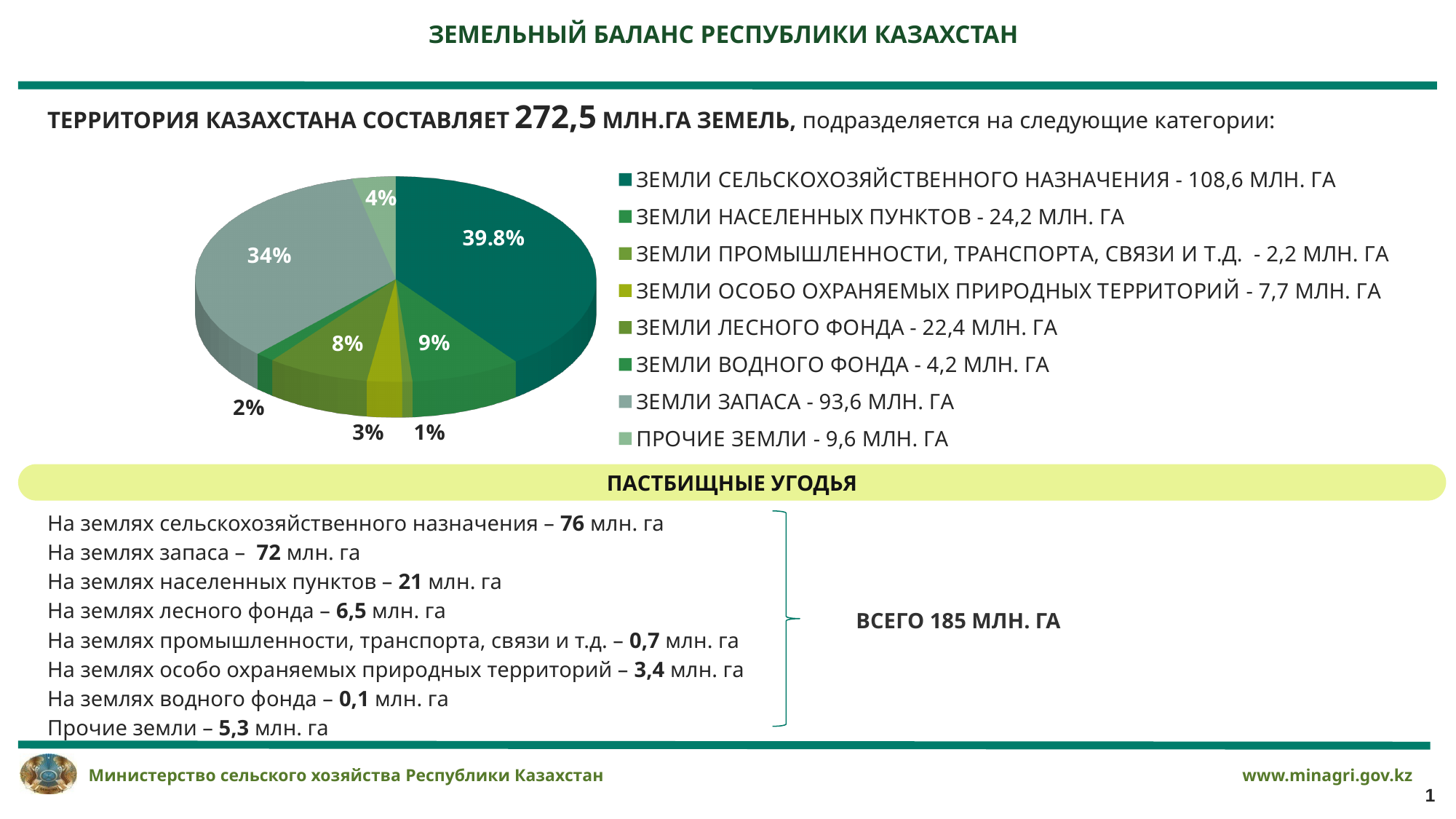
What value does the legend give for ЗЕМЛИ ВОДНОГО ФОНДА? 4,2 МЛН. ГА What kind of chart is shown on the slide? pie chart How many categories does the pie chart's legend list? 8 Which is larger according to the legend: ЗЕМЛИ НАСЕЛЕННЫХ ПУНКТОВ or ЗЕМЛИ ЛЕСНОГО ФОНДА? ЗЕМЛИ НАСЕЛЕННЫХ ПУНКТОВ Which category has the largest slice of the pie? ЗЕМЛИ СЕЛЬСКОХОЗЯЙСТВЕННОГО НАЗНАЧЕНИЯ Which category has the smallest slice of the pie? ЗЕМЛИ ПРОМЫШЛЕННОСТИ, ТРАНСПОРТА, СВЯЗИ И Т.Д. What percentage share of the pie is labelled for ЗЕМЛИ СЕЛЬСКОХОЗЯЙСТВЕННОГО НАЗНАЧЕНИЯ? 39.8% What value does the legend give for ЗЕМЛИ ЛЕСНОГО ФОНДА? 22,4 МЛН. ГА What is the difference between the pie shares of ЗЕМЛИ ЗАПАСА and ПРОЧИЕ ЗЕМЛИ? 30% What percentage share of the pie is labelled for ЗЕМЛИ ЗАПАСА? 34% What total land area does the slide state Kazakhstan's territory comprises? 272,5 МЛН.ГА What is the difference between the legend values for ЗЕМЛИ СЕЛЬСКОХОЗЯЙСТВЕННОГО НАЗНАЧЕНИЯ and ЗЕМЛИ ЗАПАСА? 15 МЛН. ГА